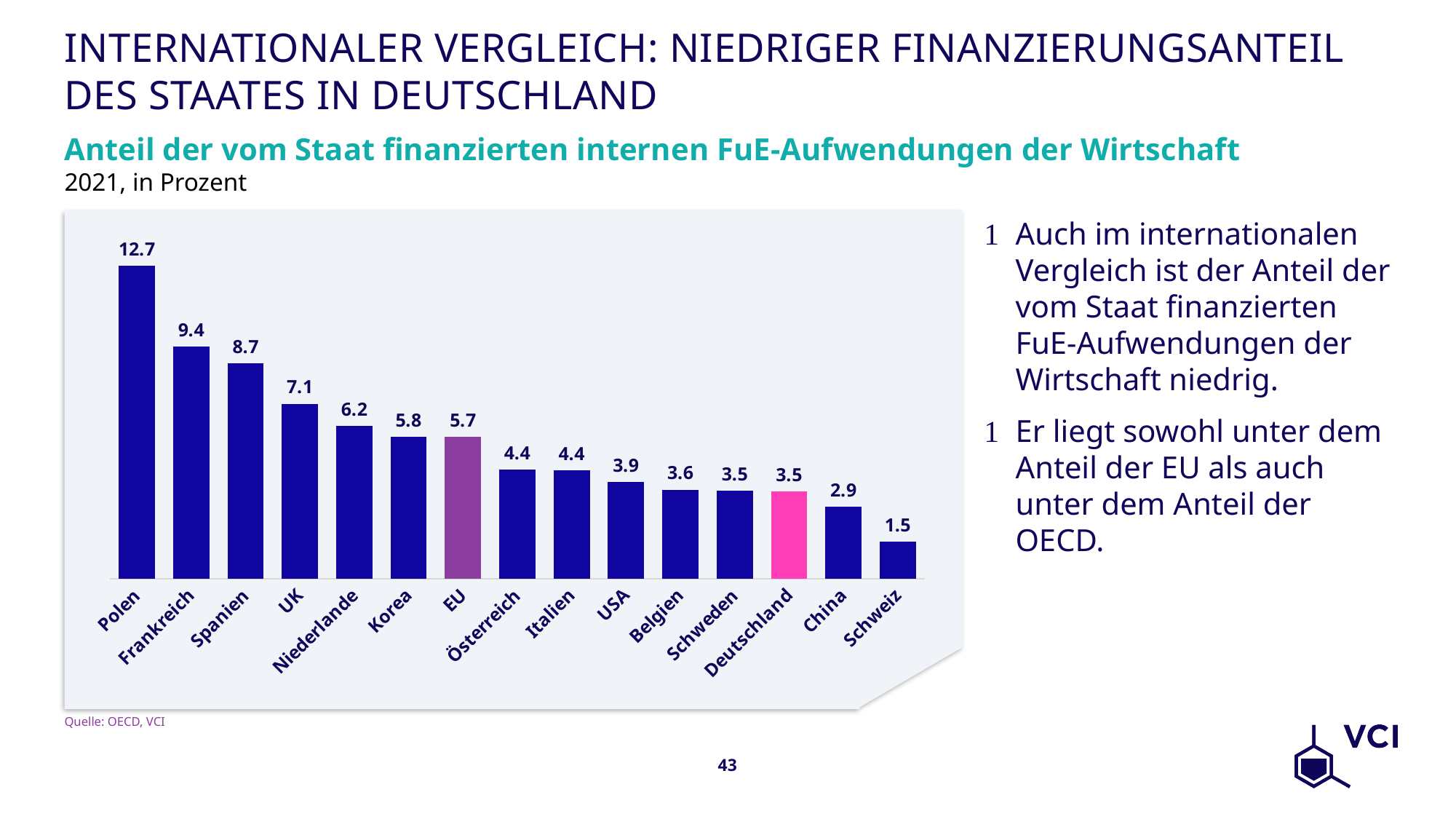
Which country has the lowest value? Schweiz What is the value for Deutschland? 3.5 How many categories are shown in the chart? 15 What is the difference between the values for EU and Deutschland? 2.2 What is the difference between the values for Polen and Schweiz? 11.2 Which country has the highest value? Polen What is the value for EU? 5.7 What kind of chart is shown on the slide? Bar chart Which has a larger value, China or Korea? Korea Which bar is highlighted in pink? Deutschland Which has a larger value, Spanien or UK? Spanien What is the value for Frankreich? 9.4